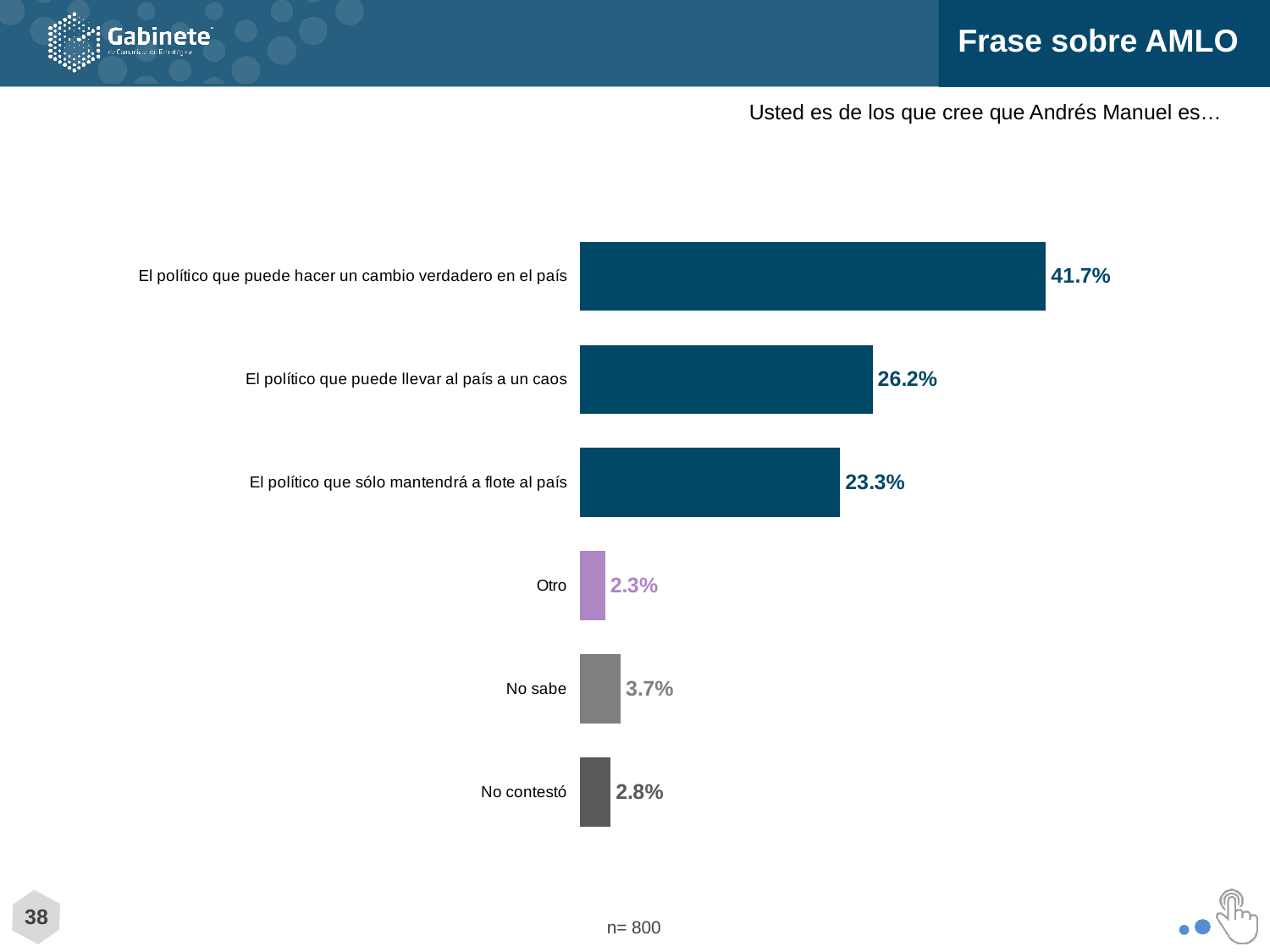
What is the value for 'El político que sólo mantendrá a flote al país'? 23.3% What is the difference between 'El político que puede hacer un cambio verdadero en el país' and 'El político que puede llevar al país a un caos'? 15.5% What type of chart is shown on the slide? Bar chart What is the value for 'El político que puede llevar al país a un caos'? 26.2% What is the sample size (n) shown on the slide? n= 800 What percentage is shown for 'No sabe'? 3.7% Which category has the lowest value? Otro What percentage of respondents chose 'El político que puede hacer un cambio verdadero en el país'? 41.7% Which category has the highest value? El político que puede hacer un cambio verdadero en el país Which is larger: 'No sabe' or 'No contestó'? No sabe What percentage is shown for 'Otro'? 2.3% How many categories are shown in the chart? 6